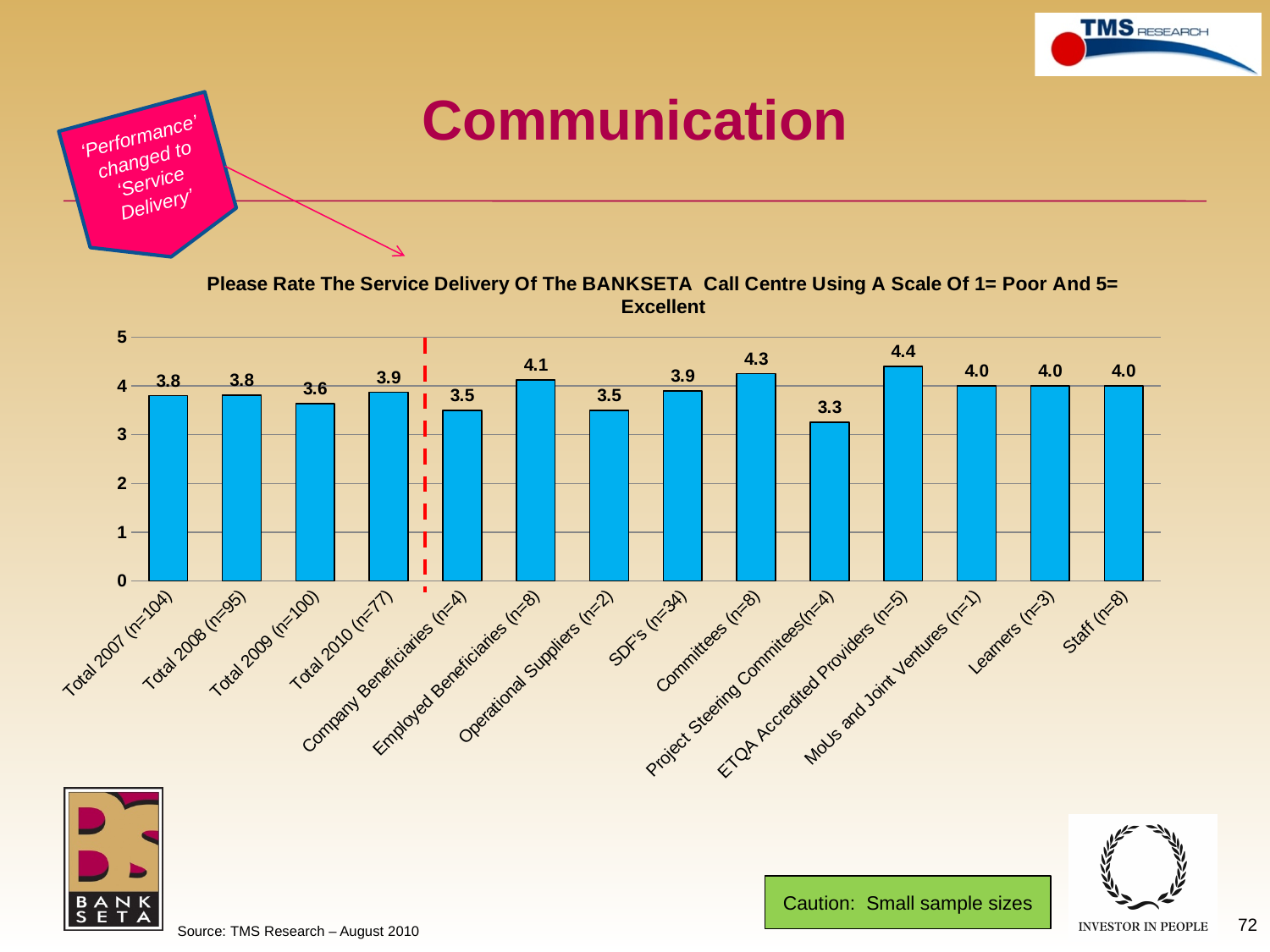
How many categories are shown on the x axis? 14 What is the rating for Total 2010 (n=77)? 3.9 What is the difference between the rating for Total 2010 (n=77) and the rating for Total 2009 (n=100)? 0.3 What is the rating for Project Steering Committees (n=4)? 3.3 Which category has the lowest rating? Project Steering Committees (n=4) Which has a higher rating, Employed Beneficiaries (n=8) or Company Beneficiaries (n=4)? Employed Beneficiaries (n=8) What is the rating for Committees (n=8)? 4.3 Which category has the highest rating? ETQA Accredited Providers (n=5) Is the rating for Total 2009 (n=100) greater or less than 4? less What is the difference between the rating for ETQA Accredited Providers (n=5) and the rating for Project Steering Committees (n=4)? 1.1 What is the maximum value shown on the y axis? 5 What kind of chart is shown on the slide? Bar chart